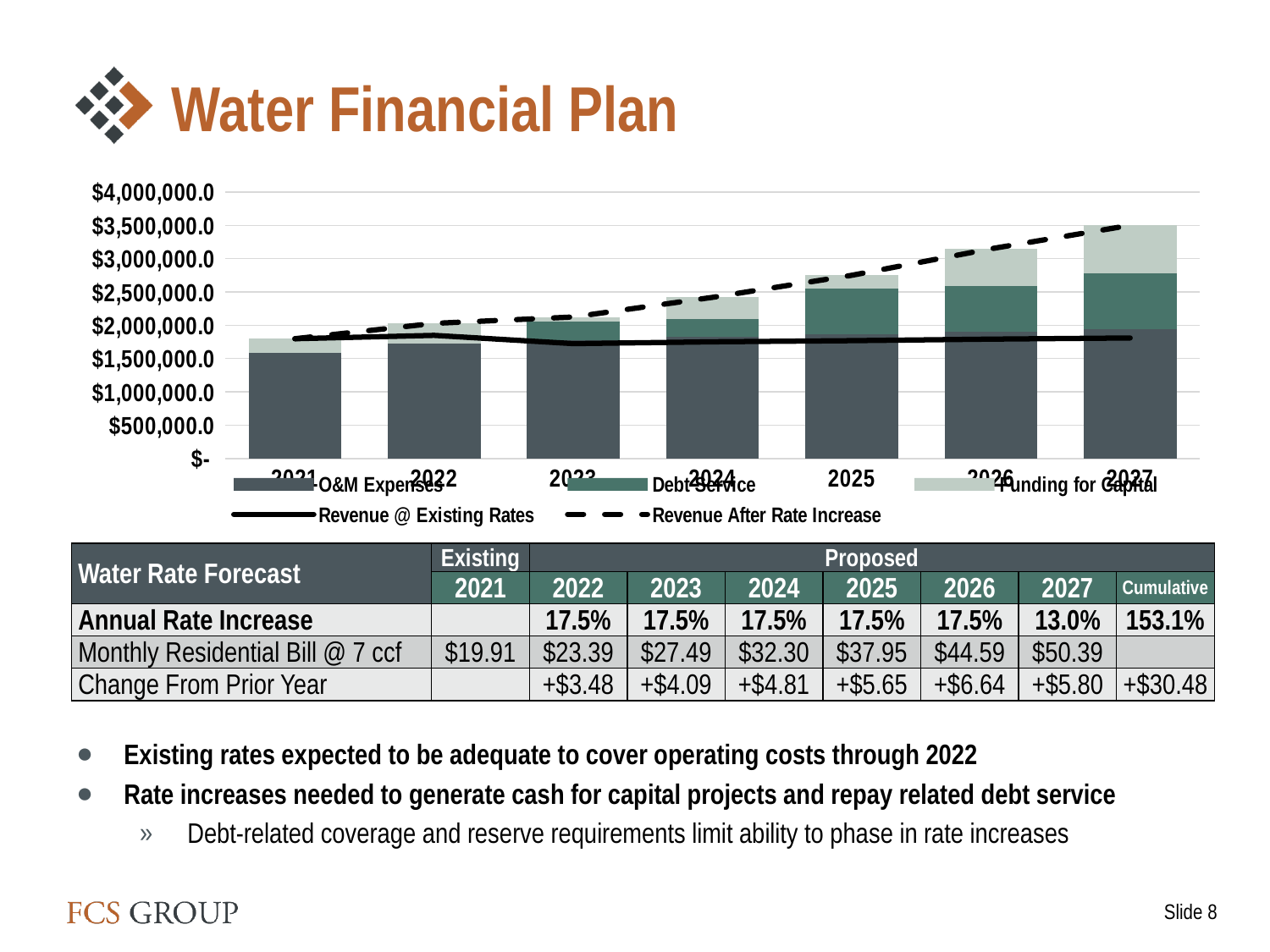
Is the Revenue @ Existing Rates value for 2027 greater or less than $2,500,000.0? less How many series does the chart legend list? 5 How many years are shown on the x axis of the chart? 7 Do the stacked bar totals rise or fall from 2021 to 2027? rise What kind of chart is shown on the slide? Stacked bar chart with line series Is the Revenue After Rate Increase value for 2027 greater or less than $3,000,000.0? greater Which legend entry is drawn as a dashed line in the chart? Revenue After Rate Increase In 2027, which line is higher: Revenue @ Existing Rates or Revenue After Rate Increase? Revenue After Rate Increase Is the total height of the stacked bar for 2027 greater or less than $3,000,000.0? greater Which year has the tallest stacked bar in the chart? 2027 Which year has the shortest stacked bar in the chart? 2021